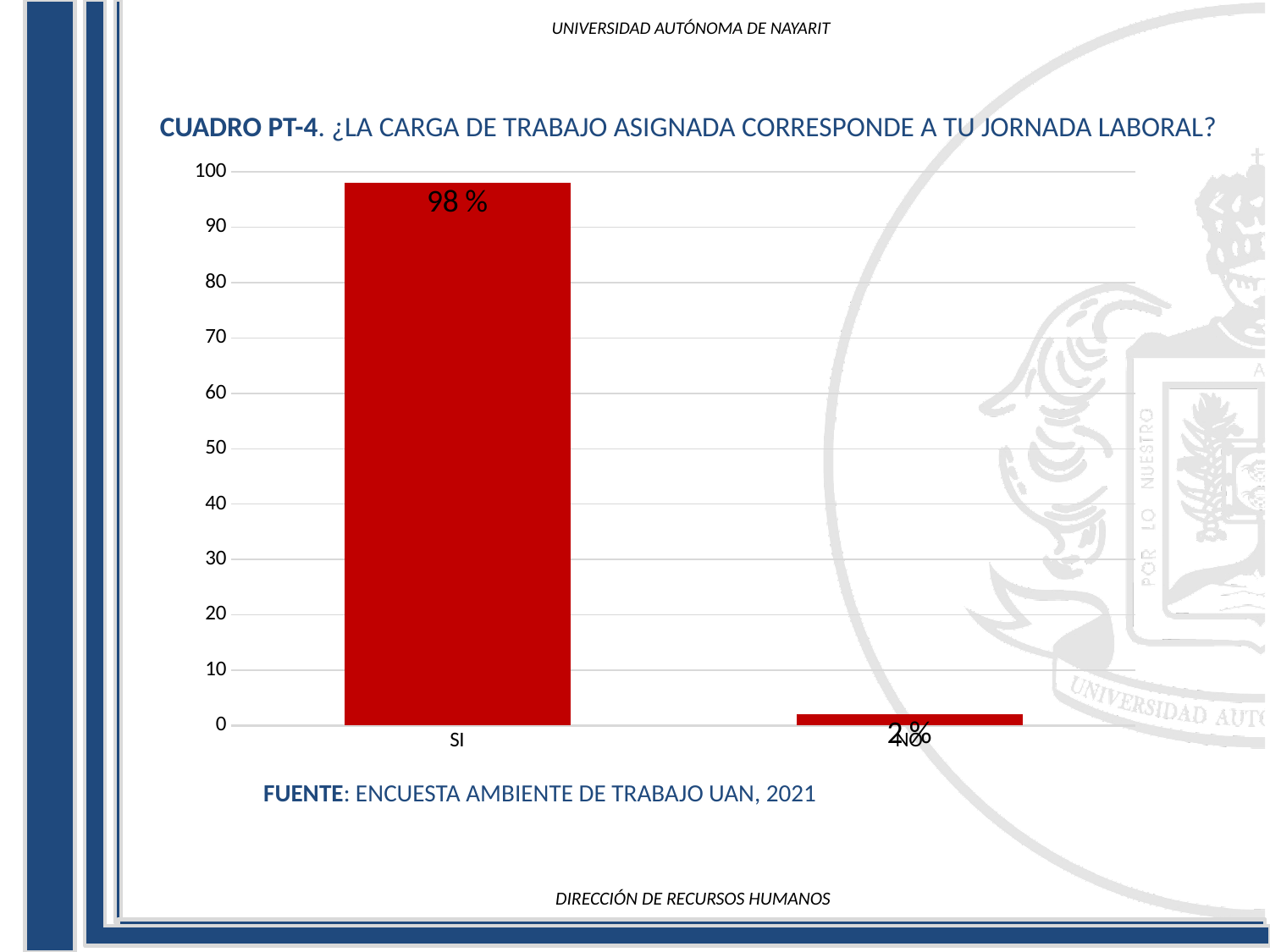
What kind of chart is shown on the slide? bar chart What value is shown for the NO bar? 2 % What source is cited below the chart? ENCUESTA AMBIENTE DE TRABAJO UAN, 2021 Which category has the highest value? SI What value is shown for the SI bar? 98 % What is the maximum value shown on the y axis? 100 What is the difference between the SI and NO values? 96 % Is the value for SI greater or less than 90? greater How many categories are shown on the x axis? 2 Is the value for NO greater or less than 10? less Which category has the lowest value? NO Which is larger, the value for SI or the value for NO? SI